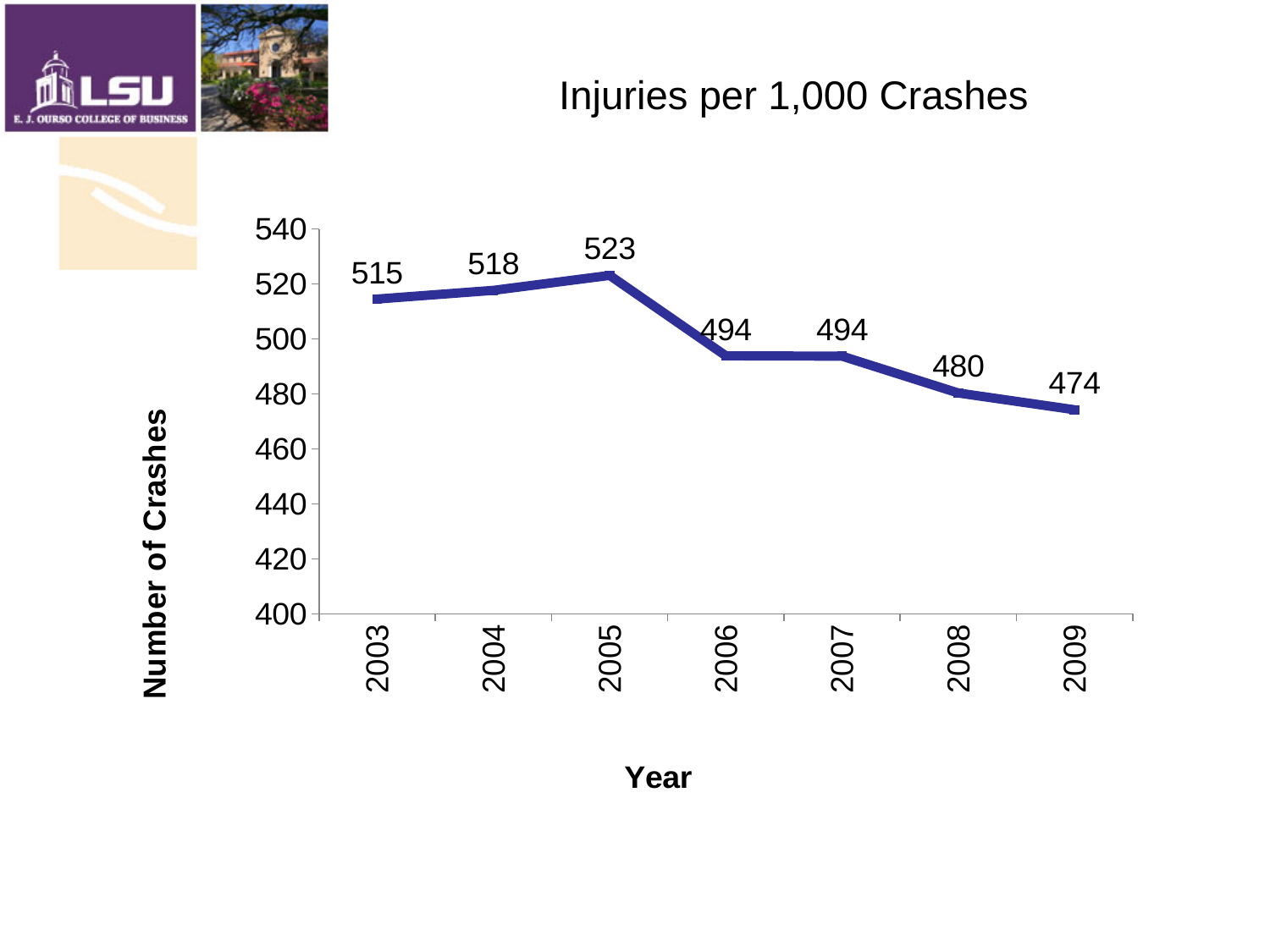
What kind of chart is shown? line chart What is the difference between the values for 2007 and 2008? 14 What is the value for 2003? 515 Do the values generally rise or fall from 2005 to 2009? fall Which is larger, the value for 2004 or the value for 2008? 2004 How many years are plotted on the chart? 7 What is the value for 2009? 474 What is the value for 2006? 494 What is the difference between the values for 2005 and 2009? 49 Which year has the lowest value? 2009 Which year has the highest value? 2005 Is the value for 2008 greater or less than 500? less